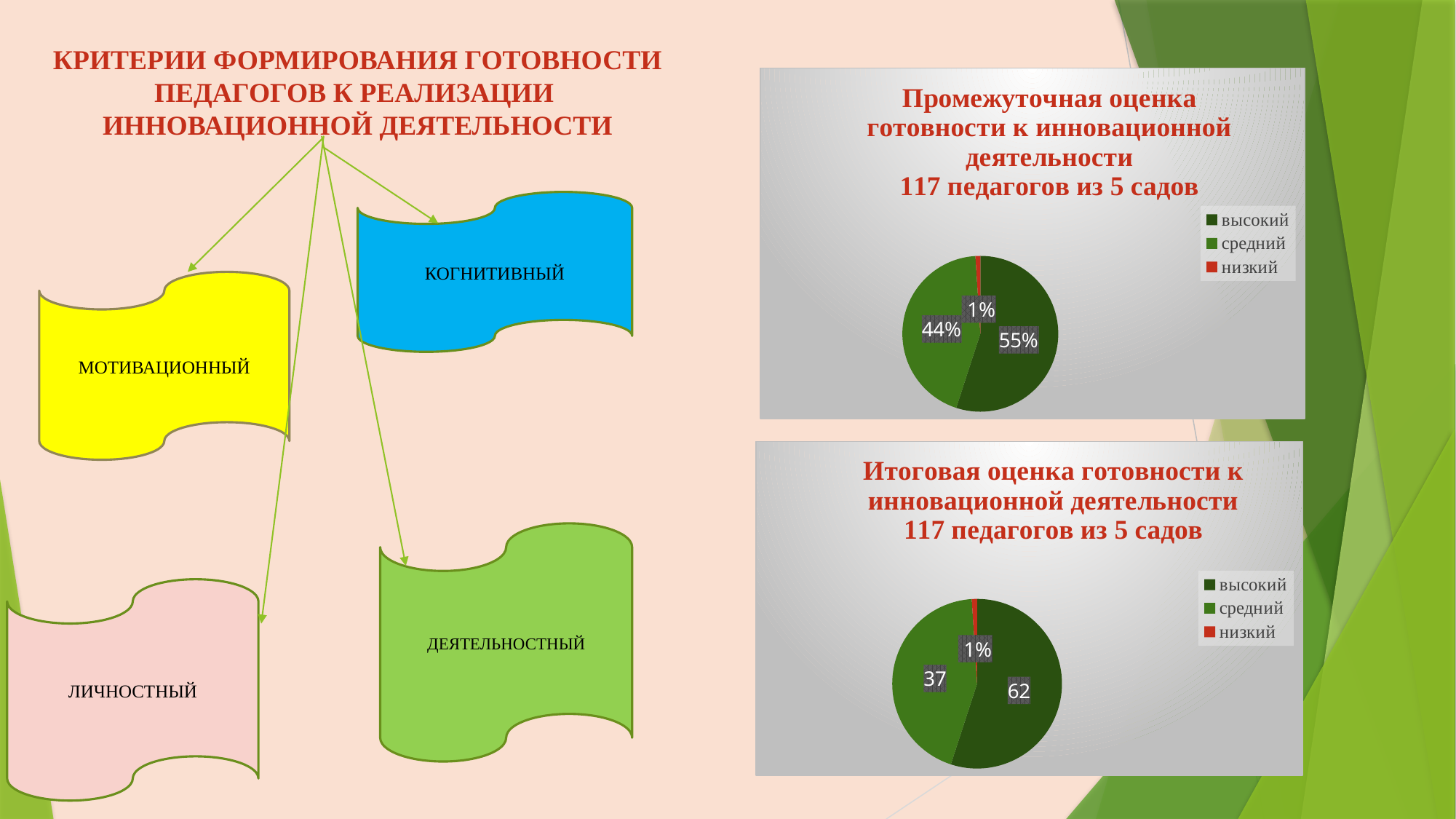
How many entries does the legend of the bottom chart 'Итоговая оценка' list? 3 In the bottom chart 'Итоговая оценка', what is the value for 'средний'? 37 In the top chart 'Промежуточная оценка', which category has the smallest slice? низкий What kind of chart is the top chart, 'Промежуточная оценка готовности к инновационной деятельности'? pie chart In the top chart 'Промежуточная оценка', what is the value for 'средний'? 44% In the bottom chart 'Итоговая оценка', which is larger, 'высокий' or 'средний'? высокий In the bottom chart 'Итоговая оценка', what is the value for 'высокий'? 62 In the top chart 'Промежуточная оценка', what is the value for 'низкий'? 1% In the top chart 'Промежуточная оценка', which category has the largest slice? высокий In the bottom chart 'Итоговая оценка', what colour is the 'низкий' slice? red In the top chart 'Промежуточная оценка', what is the difference between the 'высокий' and 'средний' values? 11% In the top chart 'Промежуточная оценка', what is the value for 'высокий'? 55%